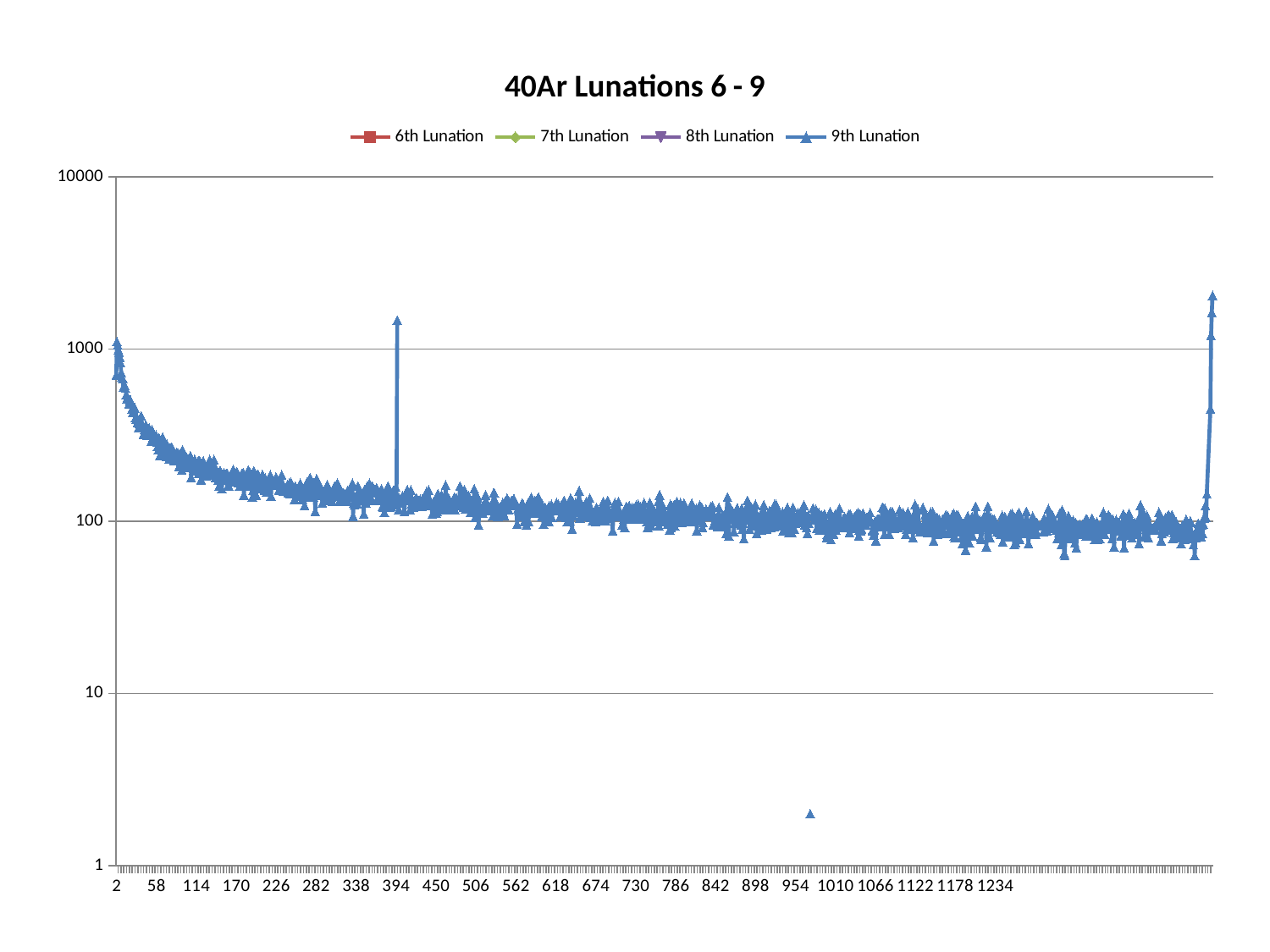
Which series is plotted with blue triangle markers? 9th Lunation Is the value for the 9th Lunation at x = 730 greater or less than 1000? less Is the value for the 9th Lunation at x = 58 greater or less than 1000? less Is the value for the 9th Lunation at x = 58 greater or less than 100? greater What is the title of the chart? 40Ar Lunations 6 - 9 How many series does the legend list? 4 Do the 9th Lunation values generally rise or fall from x = 2 to x = 1234? fall What kind of chart is shown on the slide? Line chart What is the highest value shown on the y axis? 10000